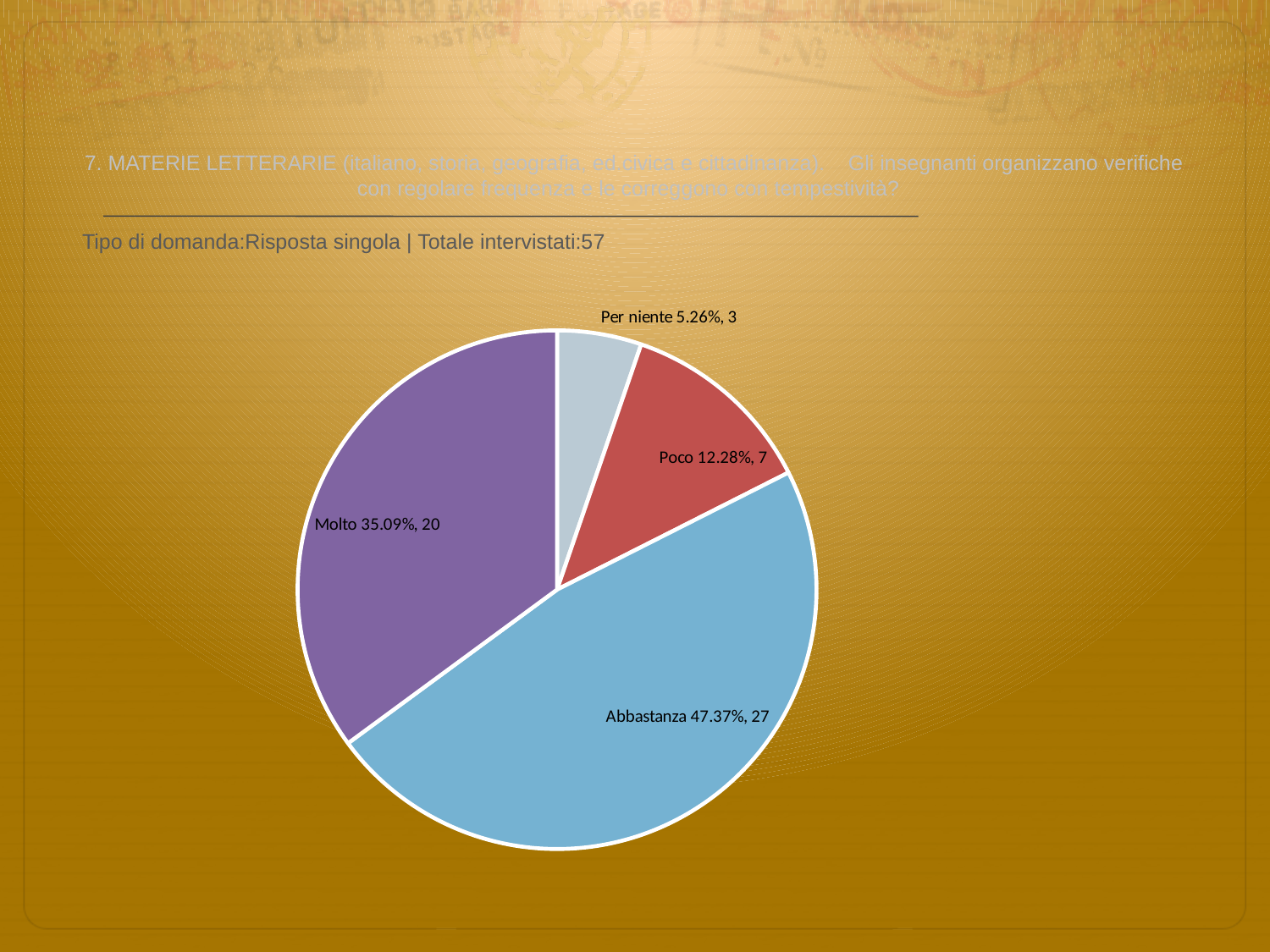
How many slices does the pie chart have? 4 Which category has the smallest slice? Per niente Which category has the largest slice? Abbastanza What percentage share does the 'Abbastanza' slice represent? 47.37% What is the total number of respondents across all slices? 57 How many respondents answered 'Poco'? 7 What is the difference in number of respondents between 'Abbastanza' and 'Molto'? 7 What percentage share does the 'Per niente' slice represent? 5.26% Which has more respondents, 'Poco' or 'Per niente'? Poco What kind of chart is shown on the slide? pie chart How many respondents answered 'Molto'? 20 What colour is the 'Molto' slice? purple